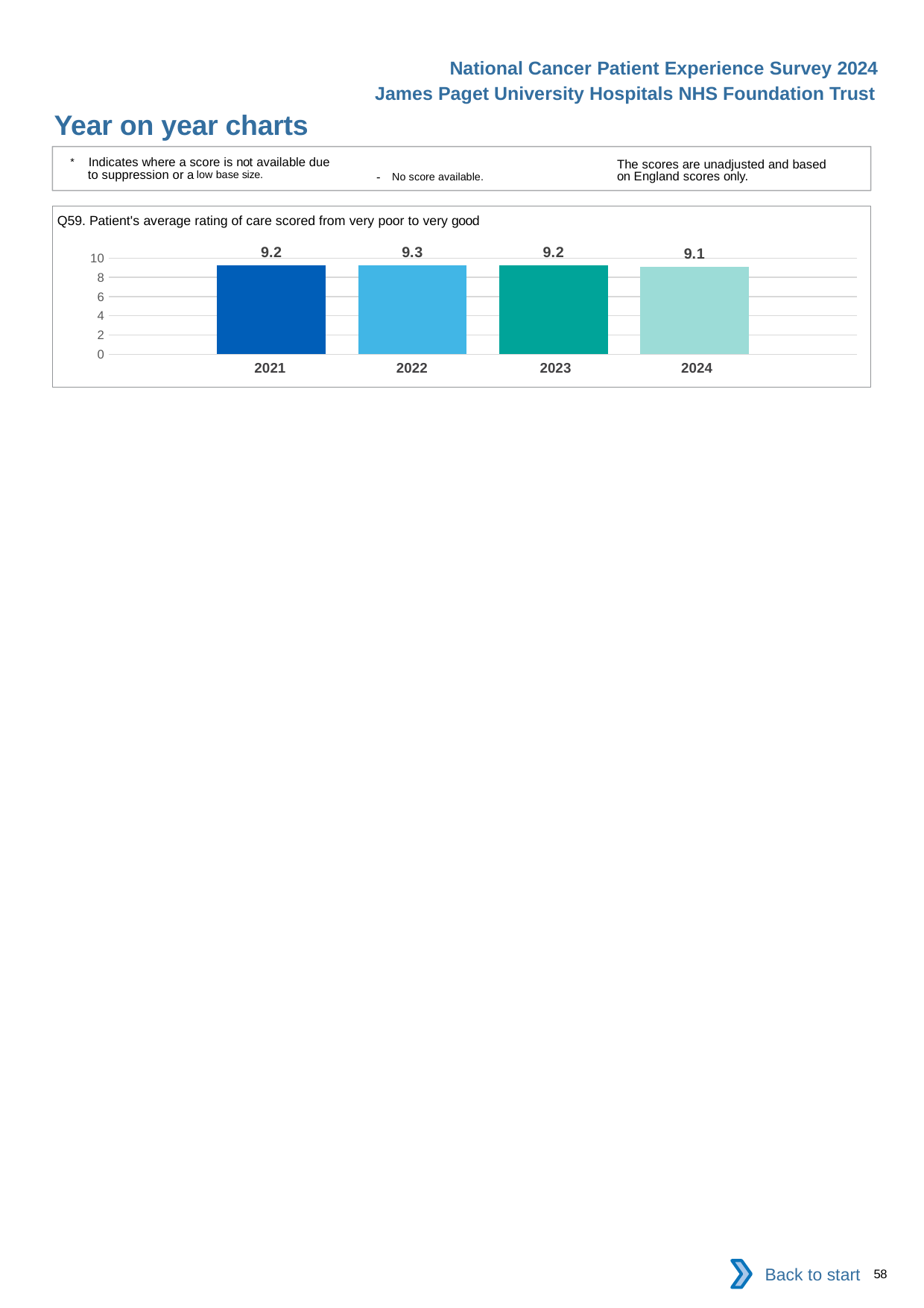
What kind of chart is shown? bar chart Which year has the lowest value? 2024 Do the values rise or fall from 2022 to 2024? fall What is the value for 2022? 9.3 What is the value for 2024? 9.1 Which year has the highest value? 2022 What is the title of the chart? Q59. Patient's average rating of care scored from very poor to very good Is the value for 2023 greater or less than 8? greater What is the difference between the values for 2022 and 2024? 0.2 What is the value for 2021? 9.2 How many years are shown on the chart? 4 Which is larger, the value for 2022 or the value for 2024? 2022